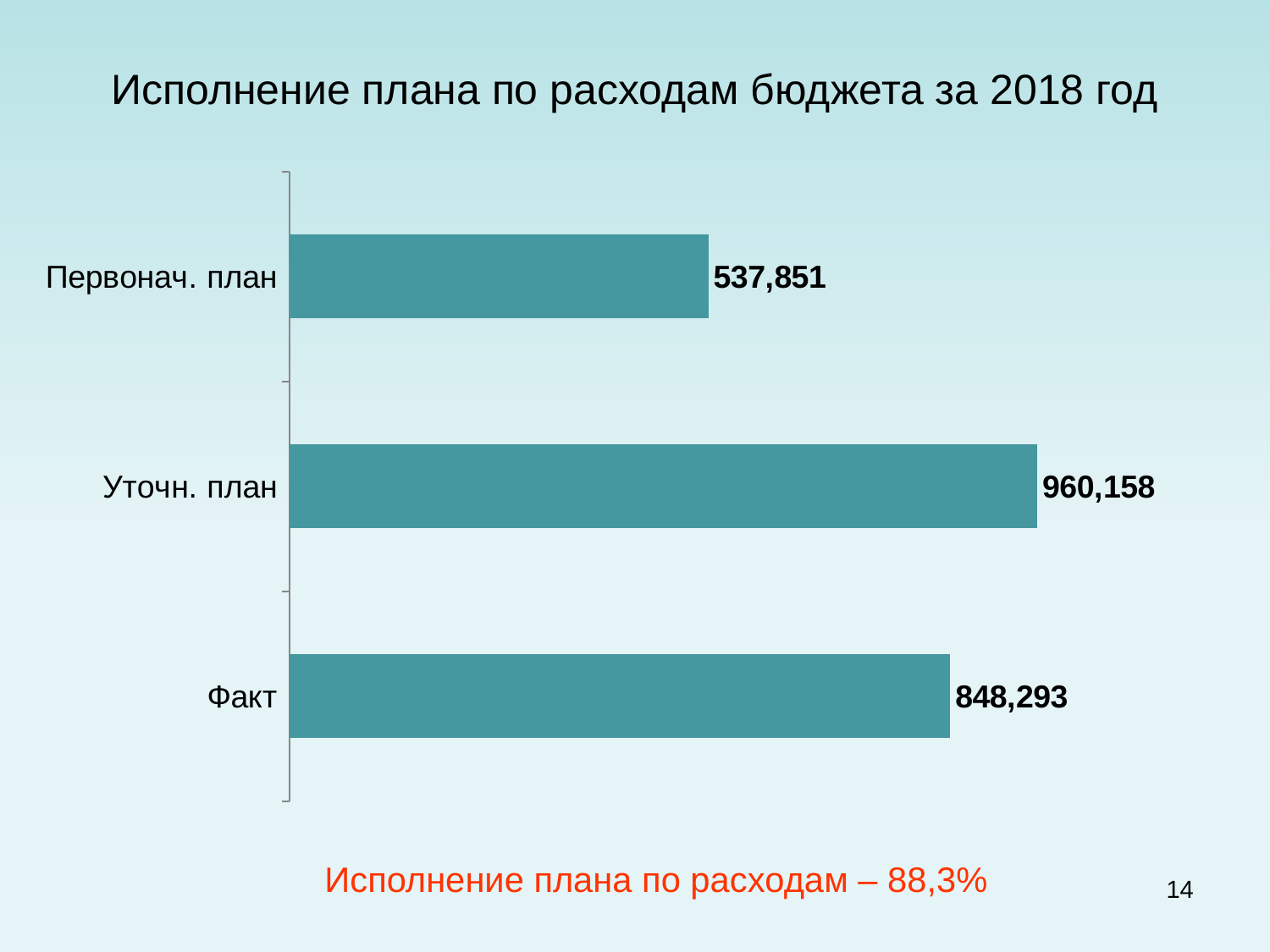
What is the value for Факт? 848,293 What is the difference between the values for Факт and Первонач. план? 310,442 What is the value for Уточн. план? 960,158 How many categories are shown in the chart? 3 What is the value for Первонач. план? 537,851 Which category has the highest value? Уточн. план What kind of chart is shown on the slide? Bar chart Which category has the lowest value? Первонач. план Which is larger, the value for Факт or the value for Первонач. план? Факт What is the difference between the values for Уточн. план and Факт? 111,865 What is the difference between the values for Уточн. план and Первонач. план? 422,307 What is the title of the slide containing the chart? Исполнение плана по расходам бюджета за 2018 год